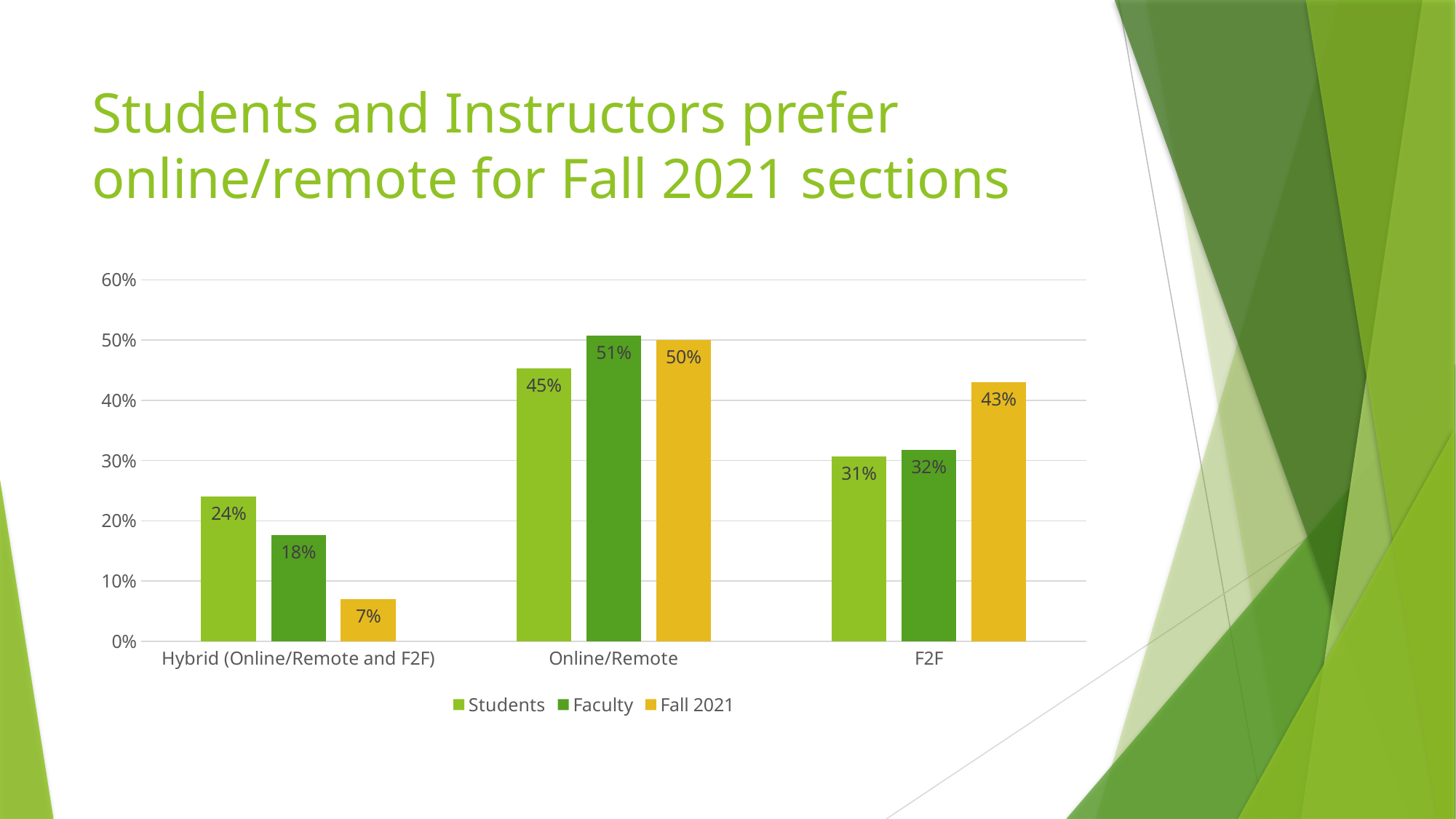
Which series is shown in yellow? Fall 2021 What is the difference between the Fall 2021 value for F2F and the Fall 2021 value for Hybrid (Online/Remote and F2F)? 36% How many series does the legend list? 3 Which category has the highest Faculty value? Online/Remote Which is larger for Hybrid (Online/Remote and F2F): the Students value or the Faculty value? Students Is the Fall 2021 value for F2F greater or less than 40%? greater What is the Students value for Online/Remote? 45% What kind of chart is shown on the slide? bar chart Which category has the lowest Fall 2021 value? Hybrid (Online/Remote and F2F) How many categories are shown on the x axis? 3 What is the Faculty value for F2F? 32% What is the Fall 2021 value for Hybrid (Online/Remote and F2F)? 7%